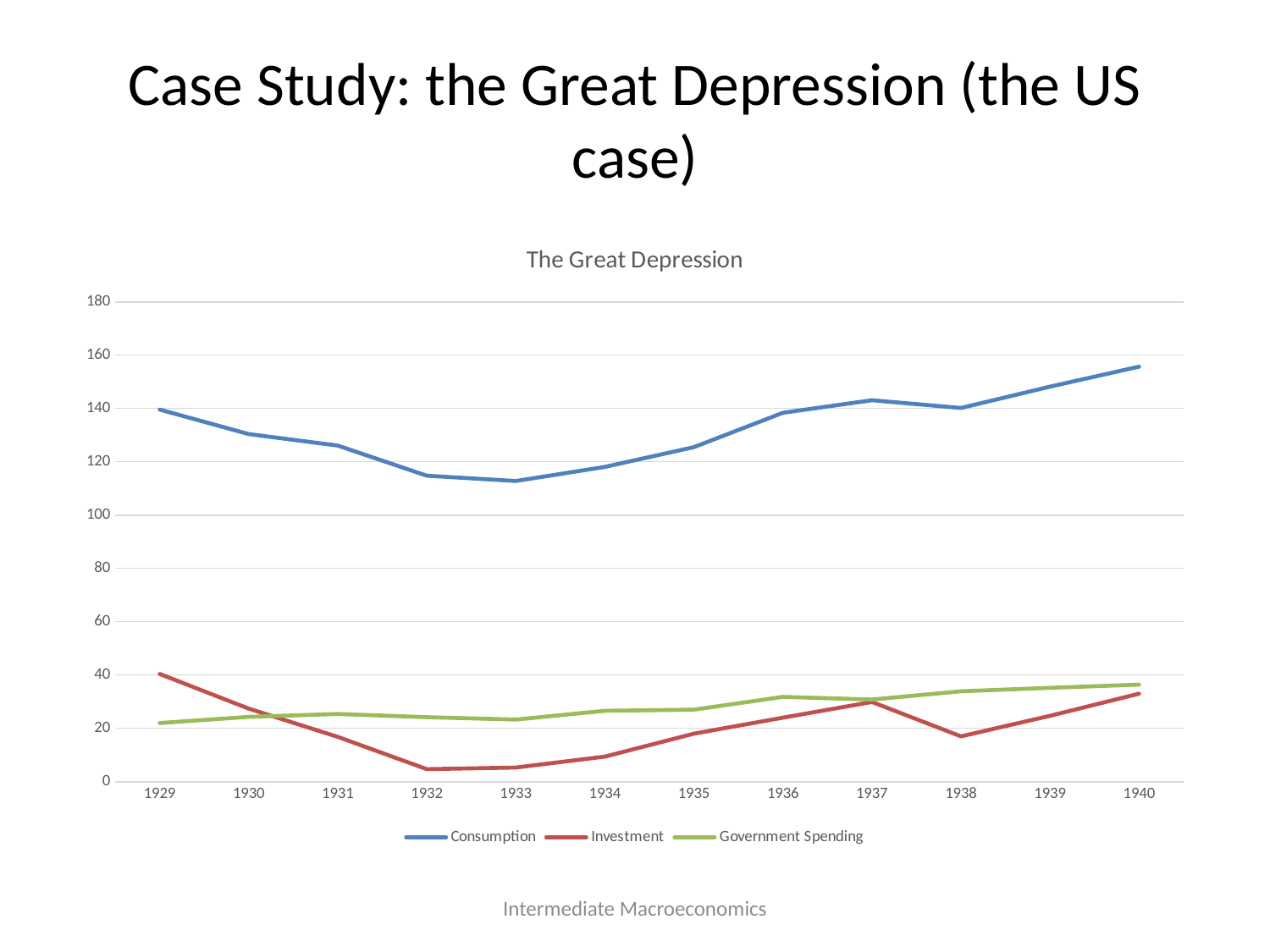
Is the value for Consumption in 1933 greater or less than 120? less Is the value for Consumption in 1929 greater or less than 120? greater What kind of chart is shown on the slide? line chart How many years are plotted along the x axis? 12 Does Consumption rise or fall from 1929 to 1933? fall In which year is Consumption highest? 1940 How many series does the legend list? 3 In which year is Investment highest? 1929 In 1929, which is larger: Investment or Government Spending? Investment In 1938, which is larger: Investment or Government Spending? Government Spending Is the value for Investment in 1932 greater or less than 20? less